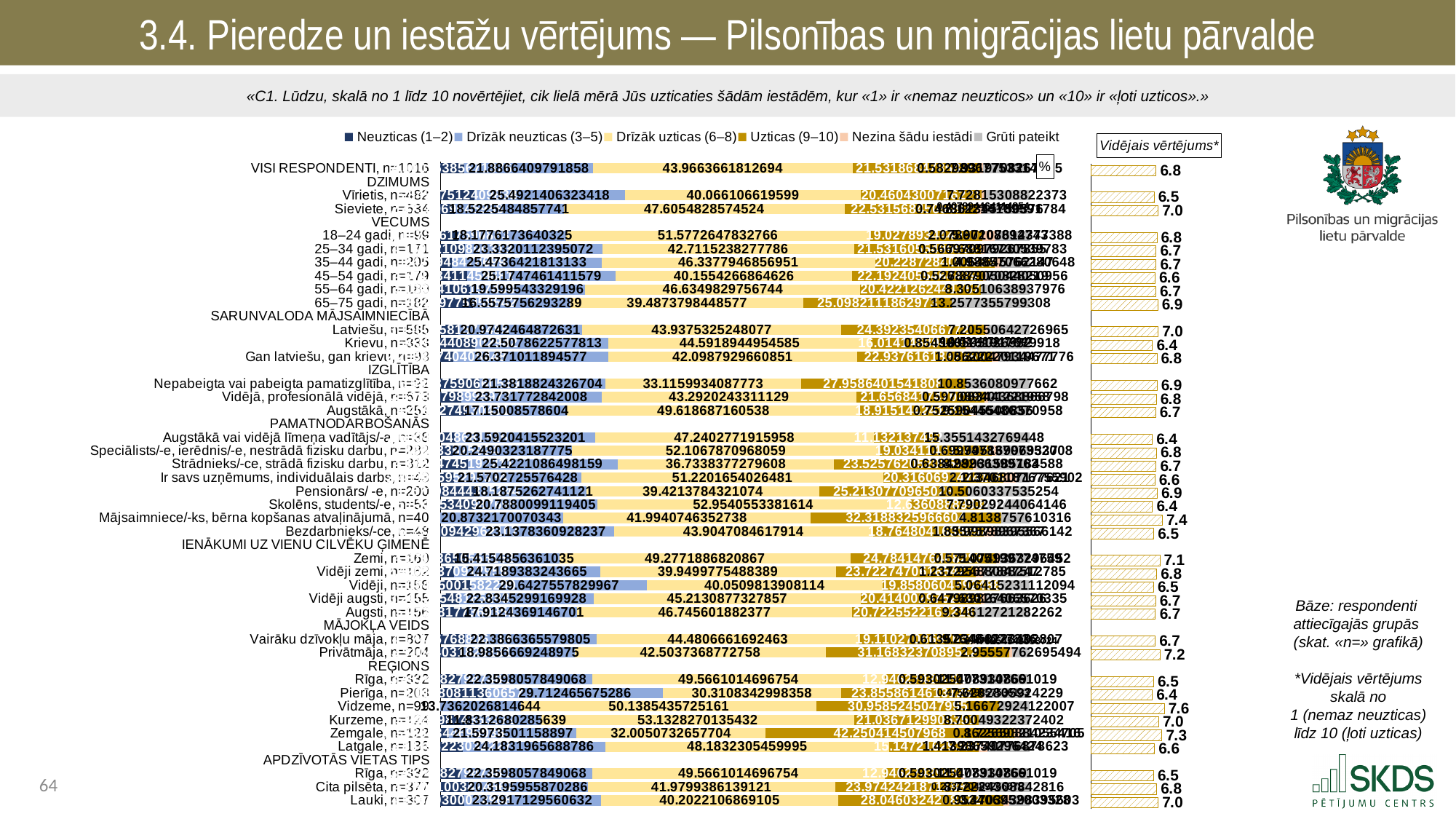
What is the average rating (Vidējais vērtējums) for Privātmāja? 7.2 What is the average rating (Vidējais vērtējums) for VISI RESPONDENTI? 6.8 What is the average rating (Vidējais vērtējums) for Vidzeme? 7.6 What is the Drīzāk uzticas (6–8) value for Kurzeme? 53.1328270135432 How many series does the legend of the stacked bar chart list? 6 Which legend entry is shown in the darkest blue colour? Neuzticas (1–2) Which has a higher average rating: Latviešu or Krievu? Latviešu Among the REĢIONS groups, which has the lowest average rating (Vidējais vērtējums)? Pierīga What is the difference between the average ratings of Sieviete and Vīrietis? 0.5 Which has a higher average rating: Zemgale or Latgale? Zemgale Which group has the highest average rating (Vidējais vērtējums) on the slide? Vidzeme What kind of chart is used to show the distribution of trust ratings by group? Stacked bar chart